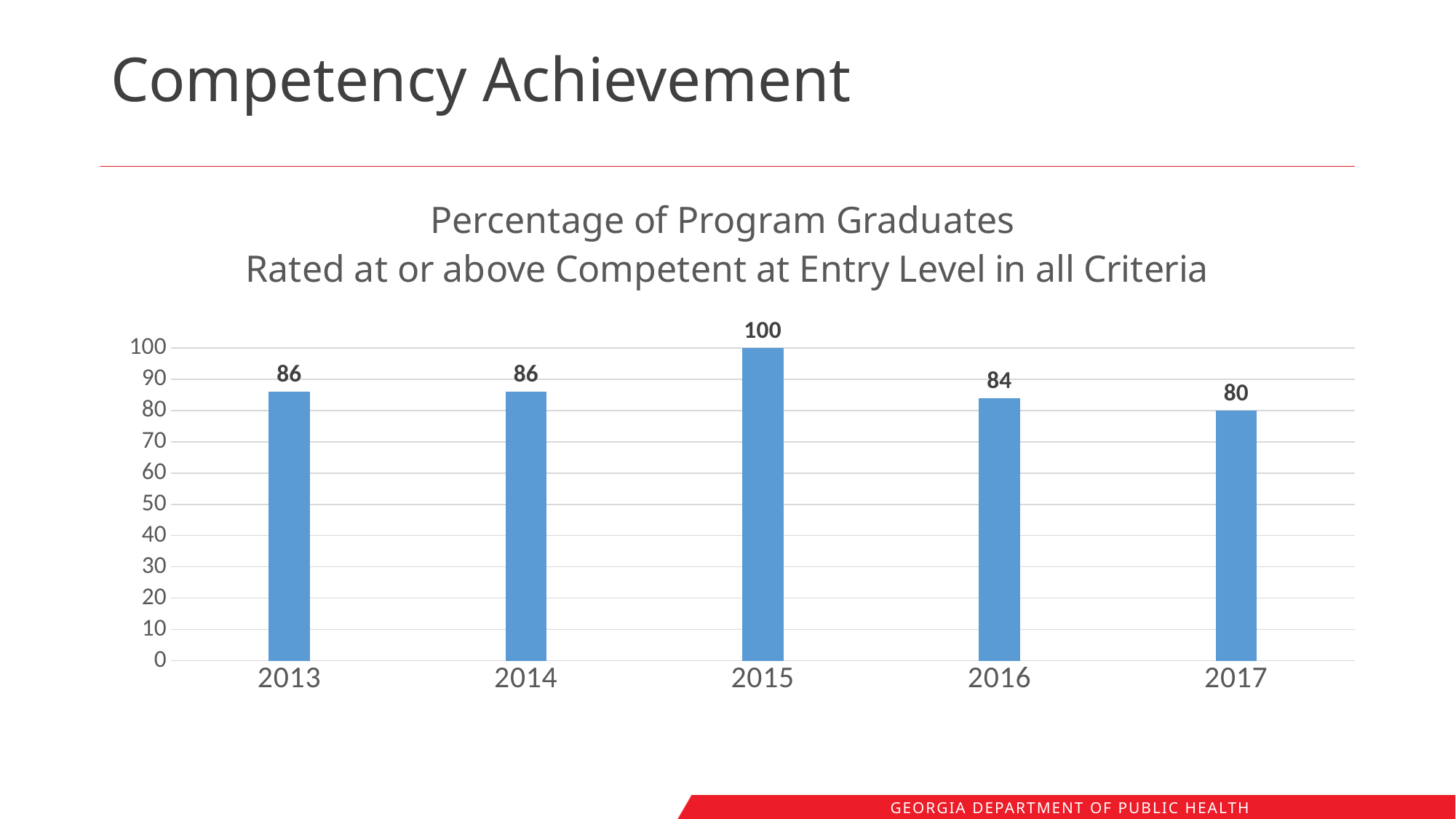
What kind of chart is shown on the slide? bar chart Is the value for 2017 greater or less than 90? less What is the value for 2016? 84 Which year has the highest value? 2015 What is the value for 2017? 80 What is the difference between the values for 2015 and 2017? 20 What is the title of the chart? Percentage of Program Graduates Rated at or above Competent at Entry Level in all Criteria What is the value for 2015? 100 Which is larger, the value for 2015 or the value for 2016? 2015 Which year has the lowest value? 2017 How many years are shown on the x axis? 5 What is the difference between the values for 2013 and 2016? 2